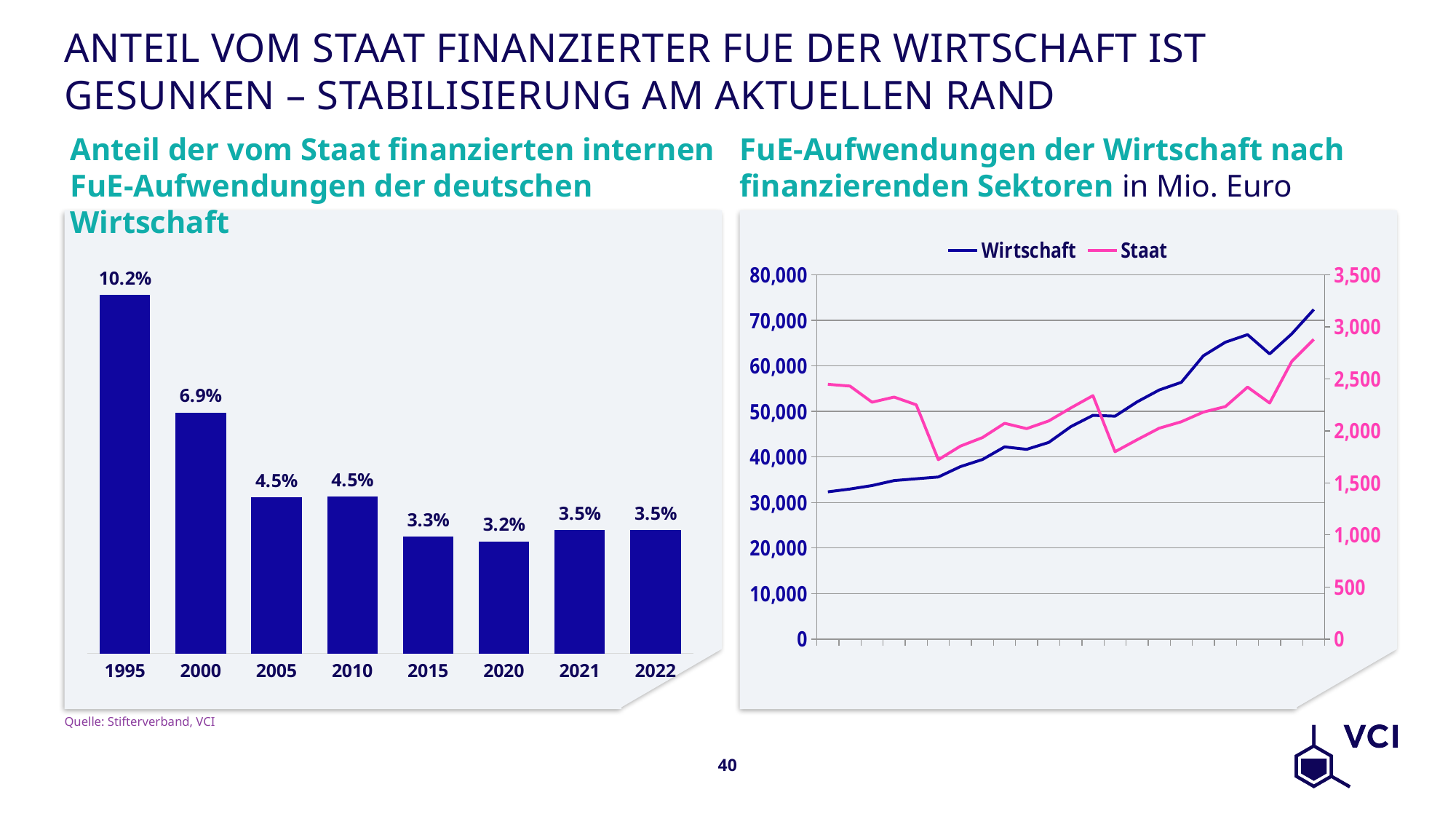
What kind of chart is the right chart? Line chart What kind of chart is the left chart? Bar chart In the left chart, what is the value for 2020? 3.2% In the right chart, which series is drawn in pink? Staat In the left chart, what is the difference between the values for 1995 and 2000? 3.3% How many bars are shown in the left chart? 8 In the left chart, which is larger, the value for 2015 or the value for 2021? 2021 In the left chart, which year has the highest value? 1995 How many series does the legend of the right chart (FuE-Aufwendungen der Wirtschaft nach finanzierenden Sektoren) list? 2 In the left chart (Anteil der vom Staat finanzierten internen FuE-Aufwendungen), what is the value for 1995? 10.2% In the left chart, which year has the lowest value? 2020 In the left chart, do the values generally rise or fall from 1995 to 2020? Fall